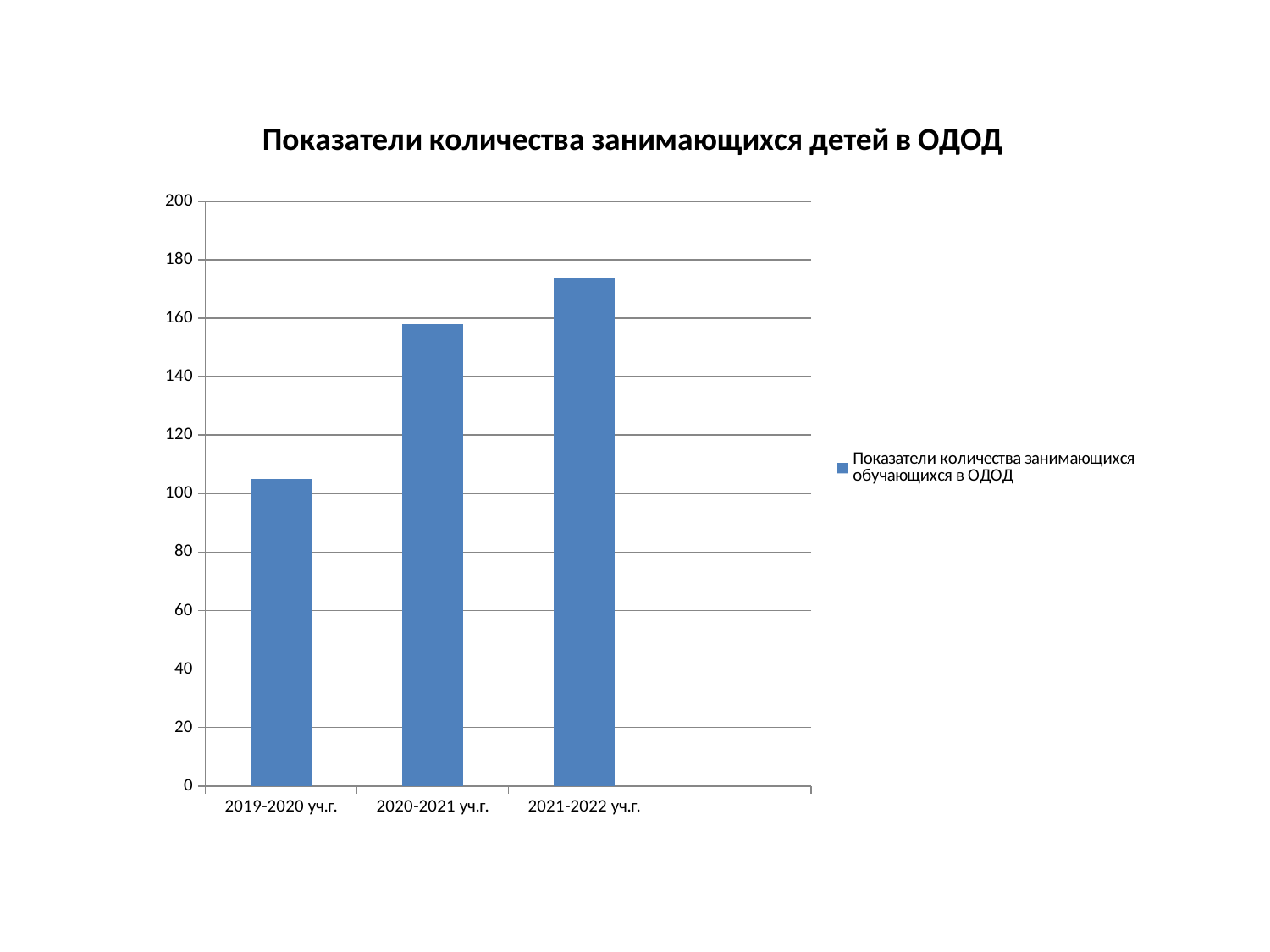
Which academic year has the highest value? 2021-2022 уч.г. Which academic year has the lowest value? 2019-2020 уч.г. Is the value for 2021-2022 уч.г. greater or less than 160? greater How many categories (academic years) are shown on the x axis? 3 Is the value for 2020-2021 уч.г. greater or less than 140? greater What is the title of the chart? Показатели количества занимающихся детей в ОДОД Is the value for 2021-2022 уч.г. greater or less than 180? less What kind of chart is shown on the slide? bar chart Do the values rise or fall from 2019-2020 уч.г. to 2021-2022 уч.г.? rise How many series does the legend list? 1 Which is larger, the value for 2020-2021 уч.г. or the value for 2019-2020 уч.г.? 2020-2021 уч.г.